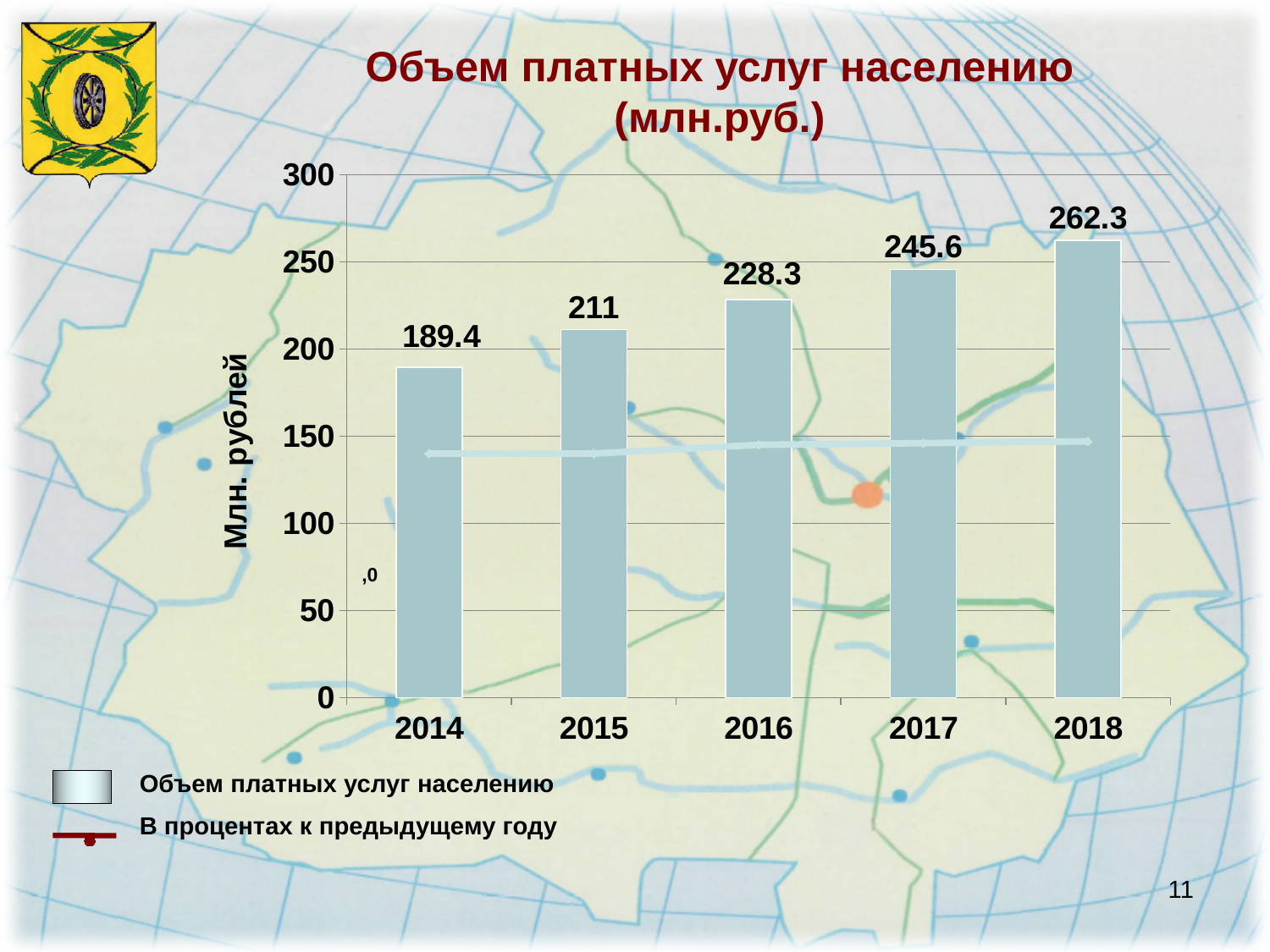
Which year has the highest value? 2018 What is the difference between the values for 2017 and 2016? 17.3 What is the value for 2016? 228.3 What is the difference between the values for 2018 and 2014? 72.9 Is the value for 2015 greater or less than 200? greater Which year has the lowest value? 2014 What is the value for 2018? 262.3 How many series does the legend list? 2 What is the value for 2014? 189.4 Which is larger, the value for 2015 or the value for 2017? 2017 How many years are shown on the x axis? 5 Do the bar values rise or fall from 2014 to 2018? rise